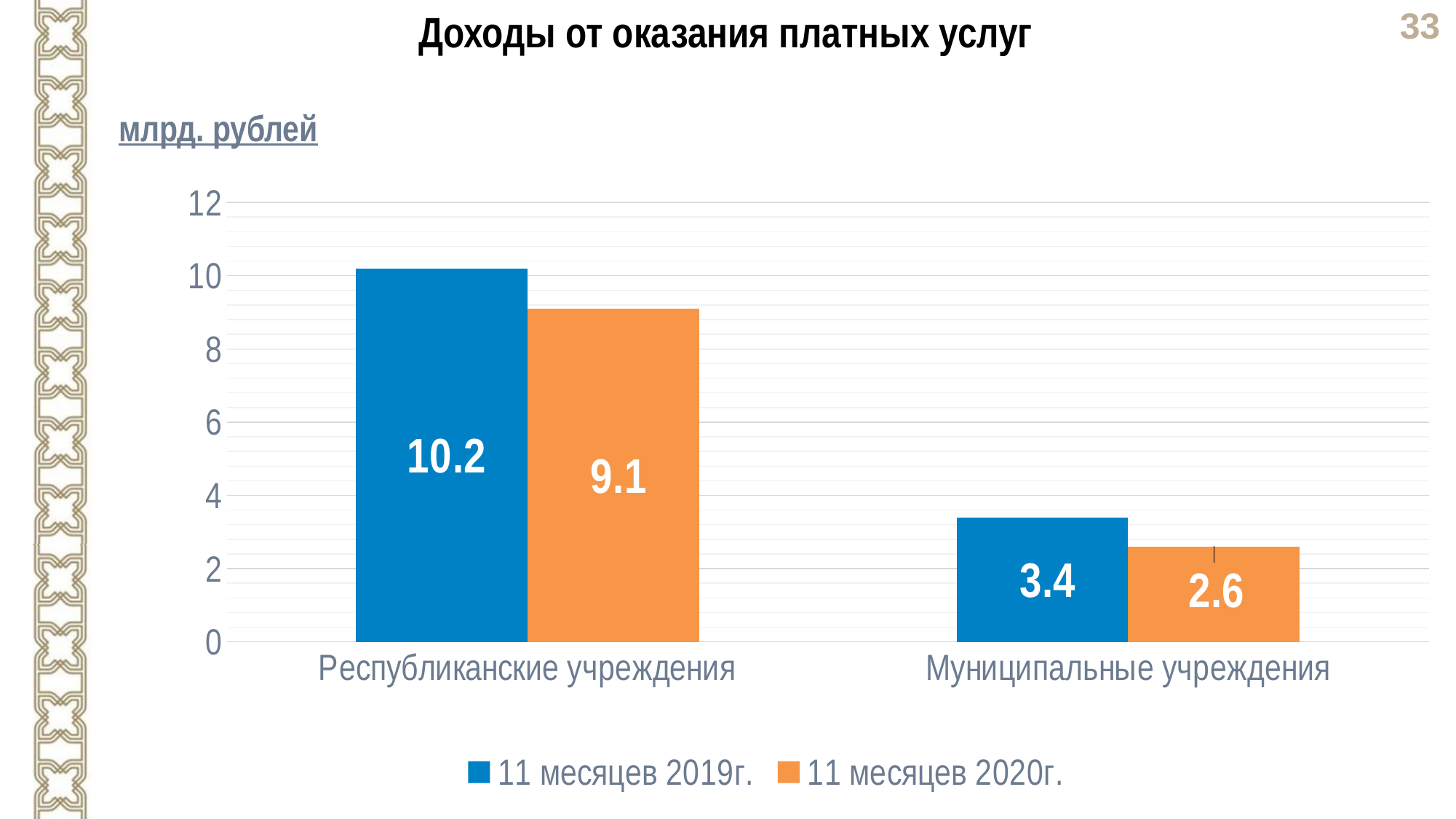
What is the difference between the 11 месяцев 2019г. and 11 месяцев 2020г. values for Республиканские учреждения? 1.1 How many series does the legend list? 2 What is the value for Республиканские учреждения in the 11 месяцев 2020г. series? 9.1 What is the difference between the 11 месяцев 2019г. and 11 месяцев 2020г. values for Муниципальные учреждения? 0.8 What kind of chart is shown on the slide? Bar chart What is the value for Муниципальные учреждения in the 11 месяцев 2020г. series? 2.6 How many categories are shown on the x axis? 2 Which category has the highest value in the 11 месяцев 2019г. series? Республиканские учреждения Which category has the lowest value in the 11 месяцев 2020г. series? Муниципальные учреждения What is the value for Республиканские учреждения in the 11 месяцев 2019г. series? 10.2 Which is larger for Муниципальные учреждения: the 11 месяцев 2019г. value or the 11 месяцев 2020г. value? 11 месяцев 2019г. What is the value for Муниципальные учреждения in the 11 месяцев 2019г. series? 3.4